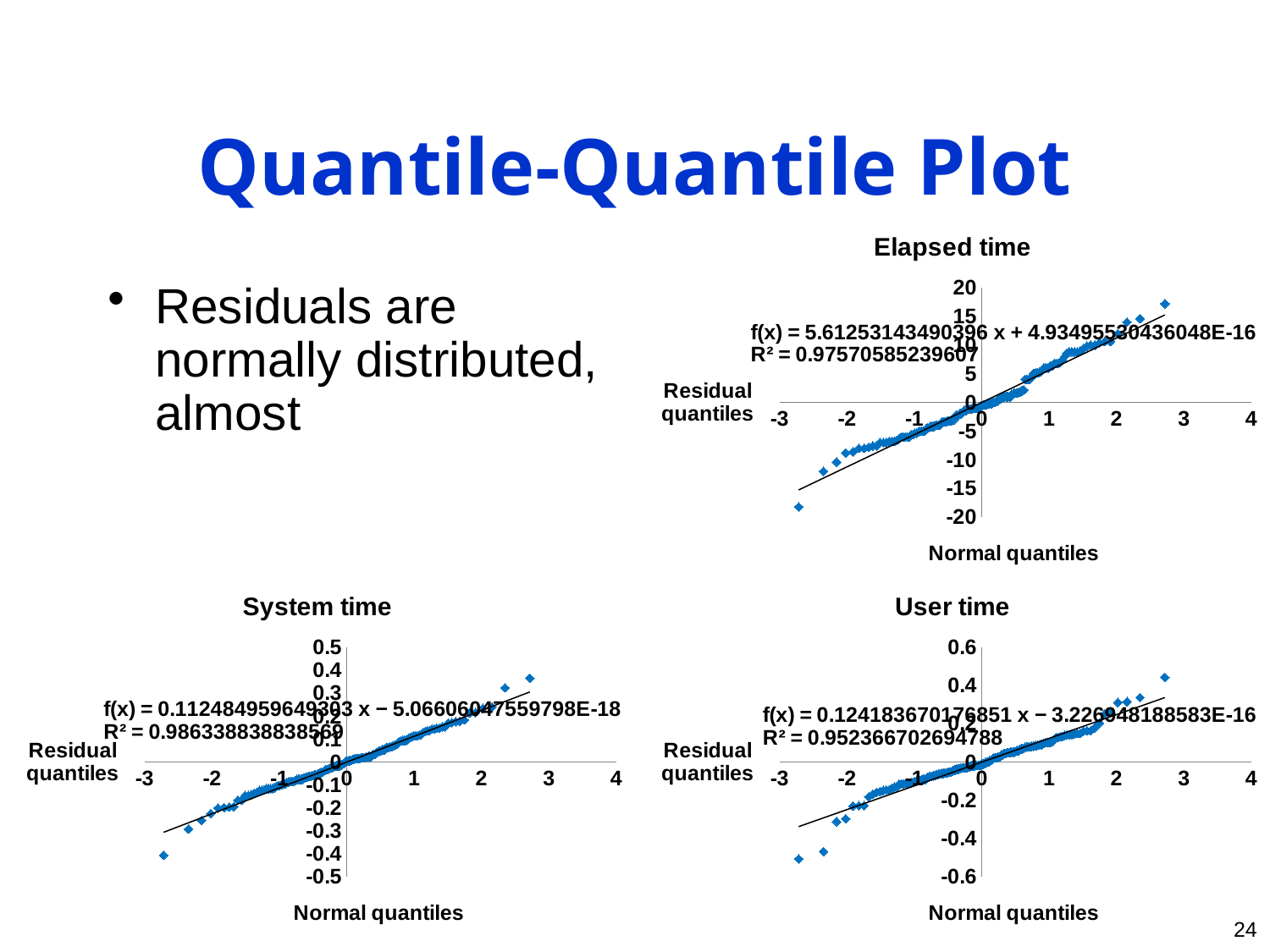
How many charts are shown on the slide? 3 In the "Elapsed time" chart, is the highest plotted point greater or less than 15? greater Which of the three charts shows the lowest R² value? User time What is the maximum value shown on the y-axis of the "User time" chart? 0.6 What kind of chart is the "Elapsed time" chart? scatter plot In the "Elapsed time" chart, is the lowest plotted point greater or less than -15? less Which of the three charts shows the highest R² value? System time In the "System time" chart, is the lowest plotted point greater or less than -0.3? less In the "Elapsed time" chart, do the residual quantiles rise or fall as the normal quantiles increase? rise What is the R² value shown on the "User time" chart? 0.952366702694788 What is the x-axis label on the "User time" chart? Normal quantiles In the "System time" chart, do the plotted points rise or fall from left to right? rise